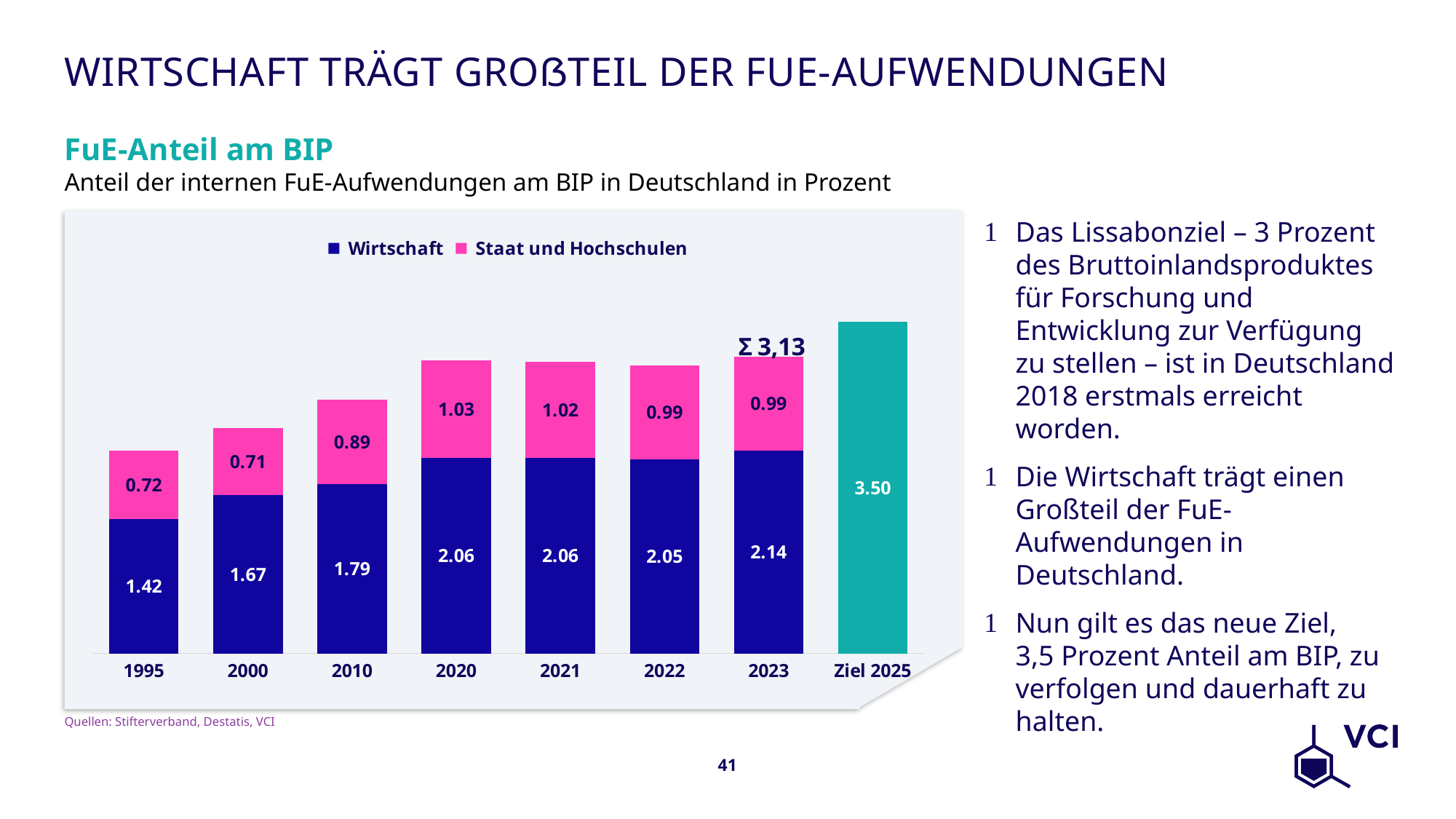
What is the Staat und Hochschulen value for 2020? 1.03 Which is larger in 2010, the Wirtschaft value or the Staat und Hochschulen value? Wirtschaft What is the total of the stacked bar for 1995? 2.14 What is the Wirtschaft value for 2023? 2.14 What kind of chart is shown on the slide? Stacked bar chart In which year is the Wirtschaft value the lowest? 1995 What is the total shown above the 2023 bar? Σ 3,13 How many series does the legend list? 2 What is the difference between the Wirtschaft values for 2023 and 1995? 0.72 How many categories are shown on the x axis? 8 What value is shown for Ziel 2025? 3.50 In which year is the Staat und Hochschulen value the highest? 2020